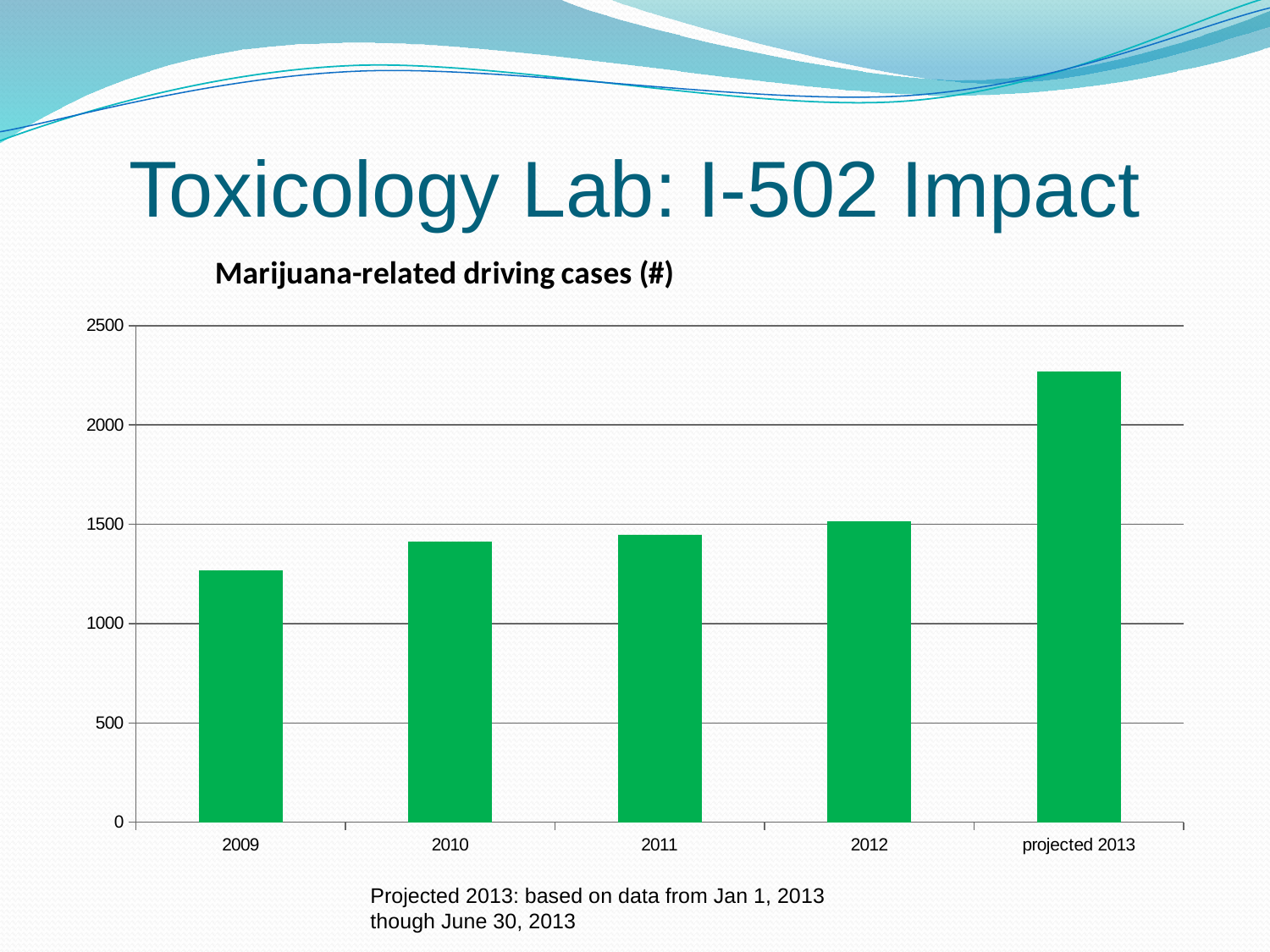
Which category has the lowest number of marijuana-related driving cases? 2009 Is the value for projected 2013 greater or less than 2000? greater Which category has the highest number of marijuana-related driving cases? projected 2013 Do the values rise or fall from 2009 to projected 2013? rise Is the value for 2012 greater or less than 1000? greater Is the value for 2010 greater or less than 1500? less What type of chart is shown on the slide? bar chart What is the title of the chart? Marijuana-related driving cases (#) Which is larger, the value for 2009 or the value for 2012? 2012 How many categories are shown on the x axis of the chart? 5